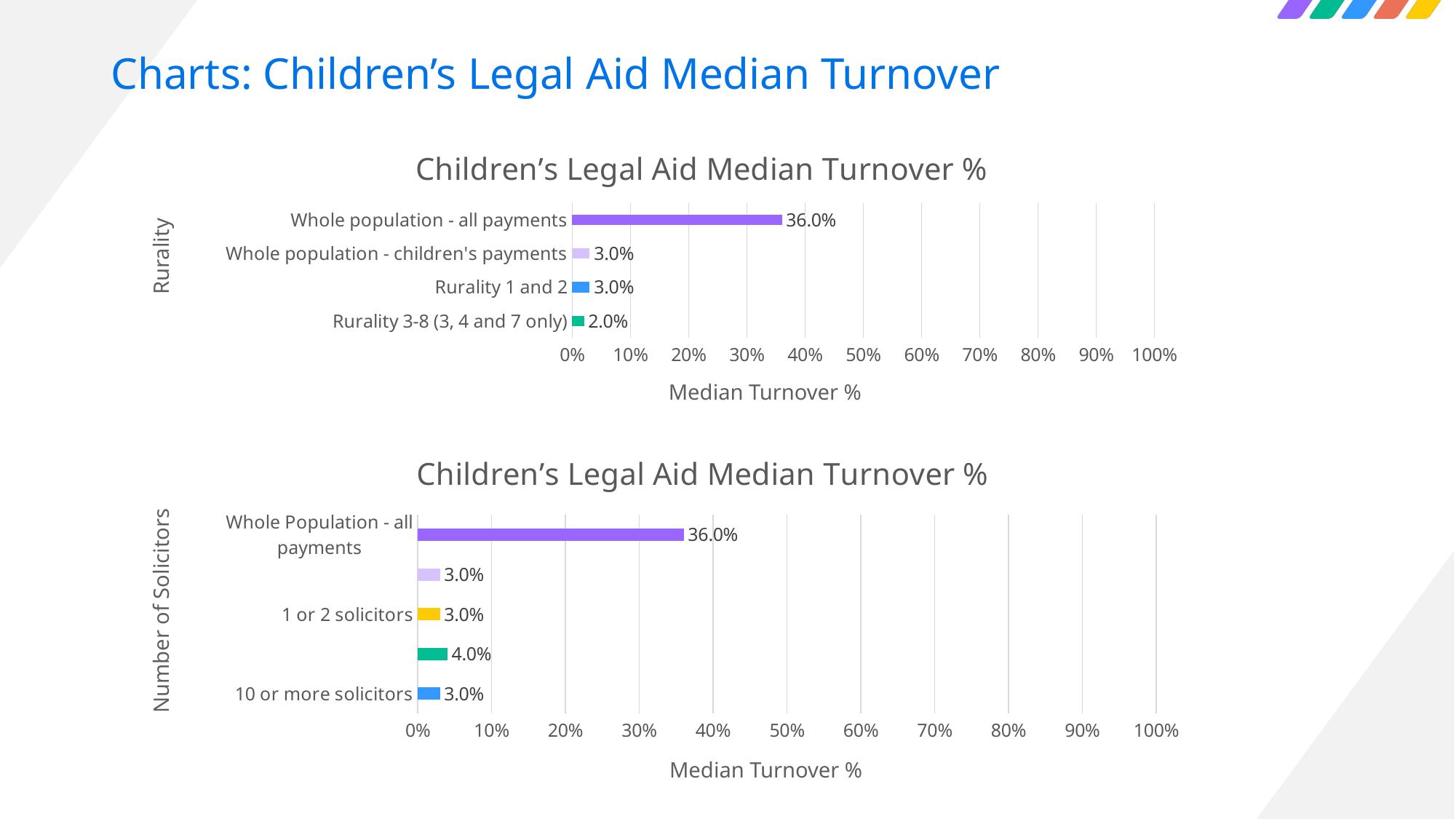
In the top chart (Rurality), what is the median turnover % for Whole population - all payments? 36.0% In the bottom chart (Number of Solicitors), which category has the highest median turnover %? Whole Population - all payments In the top chart (Rurality), what is the median turnover % for Rurality 1 and 2? 3.0% In the bottom chart (Number of Solicitors), how many bars are plotted? 5 In the top chart (Rurality), how many categories are plotted? 4 What kind of chart is the top chart (Rurality)? Bar chart In the bottom chart (Number of Solicitors), what is the median turnover % for 10 or more solicitors? 3.0% In the bottom chart (Number of Solicitors), what is the median turnover % for 1 or 2 solicitors? 3.0% In the top chart (Rurality), which category has the lowest median turnover %? Rurality 3-8 (3, 4 and 7 only) In the top chart (Rurality), what is the difference between Whole population - all payments and Whole population - children's payments? 33.0% In the top chart (Rurality), what is the median turnover % for Rurality 3-8 (3, 4 and 7 only)? 2.0% What is the x-axis title of the bottom chart (Number of Solicitors)? Median Turnover %